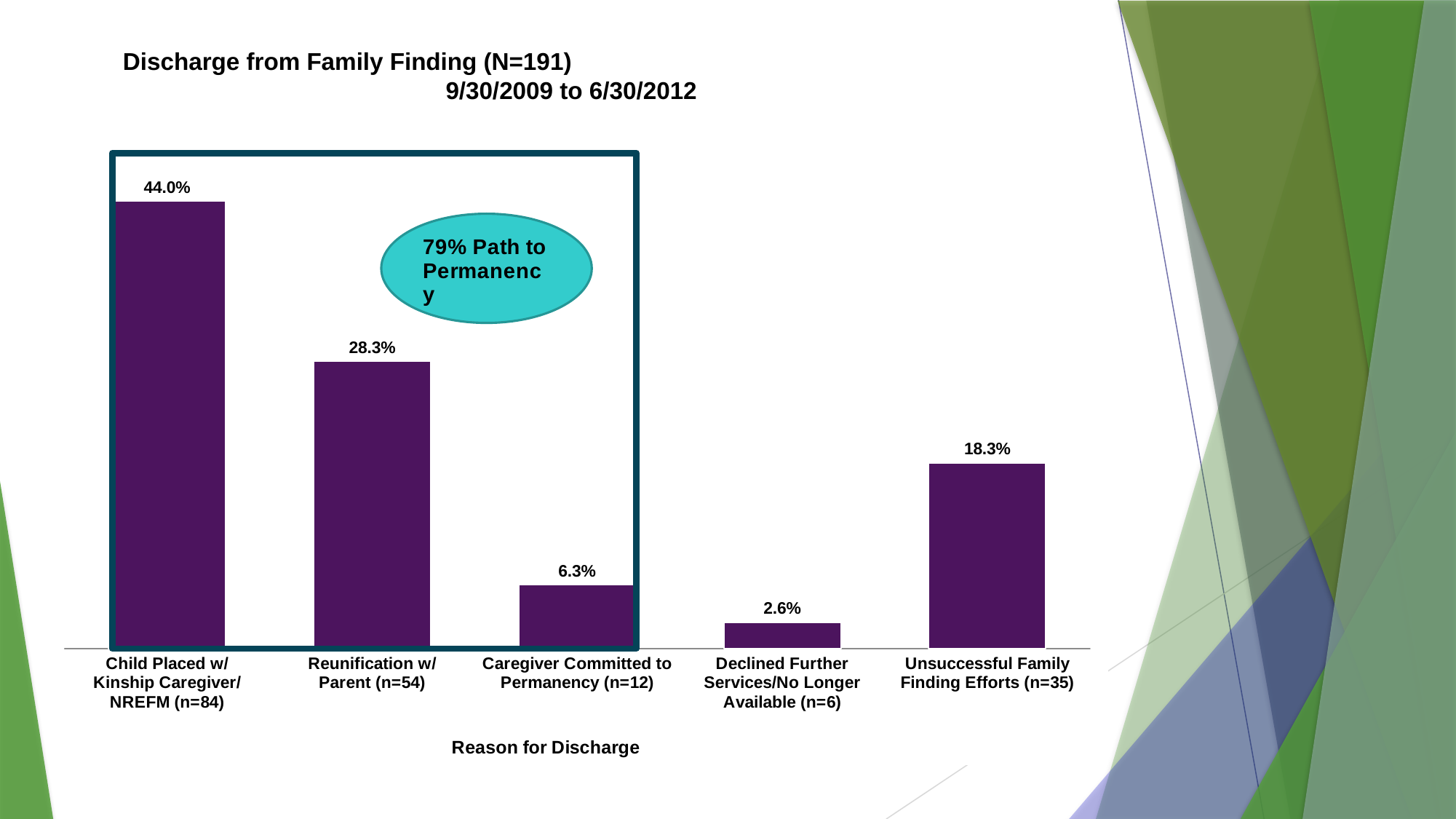
Which reason for discharge has the highest percentage? Child Placed w/ Kinship Caregiver/NREFM What percentage of discharges were for Caregiver Committed to Permanency? 6.3% How many reasons for discharge are shown on the chart? 5 Which reason for discharge has the lowest percentage? Declined Further Services/No Longer Available What percentage of discharges were for Declined Further Services/No Longer Available? 2.6% What percentage of discharges were for Unsuccessful Family Finding Efforts? 18.3% What is the total N given in the chart title? 191 What kind of chart is shown on the slide? Bar chart What percentage of discharges were for Reunification w/ Parent? 28.3% What is the difference in percentage points between Child Placed w/ Kinship Caregiver/NREFM and Reunification w/ Parent? 15.7 Which is larger: the percentage for Unsuccessful Family Finding Efforts or for Caregiver Committed to Permanency? Unsuccessful Family Finding Efforts What percentage of discharges were for Child Placed w/ Kinship Caregiver/NREFM? 44.0%